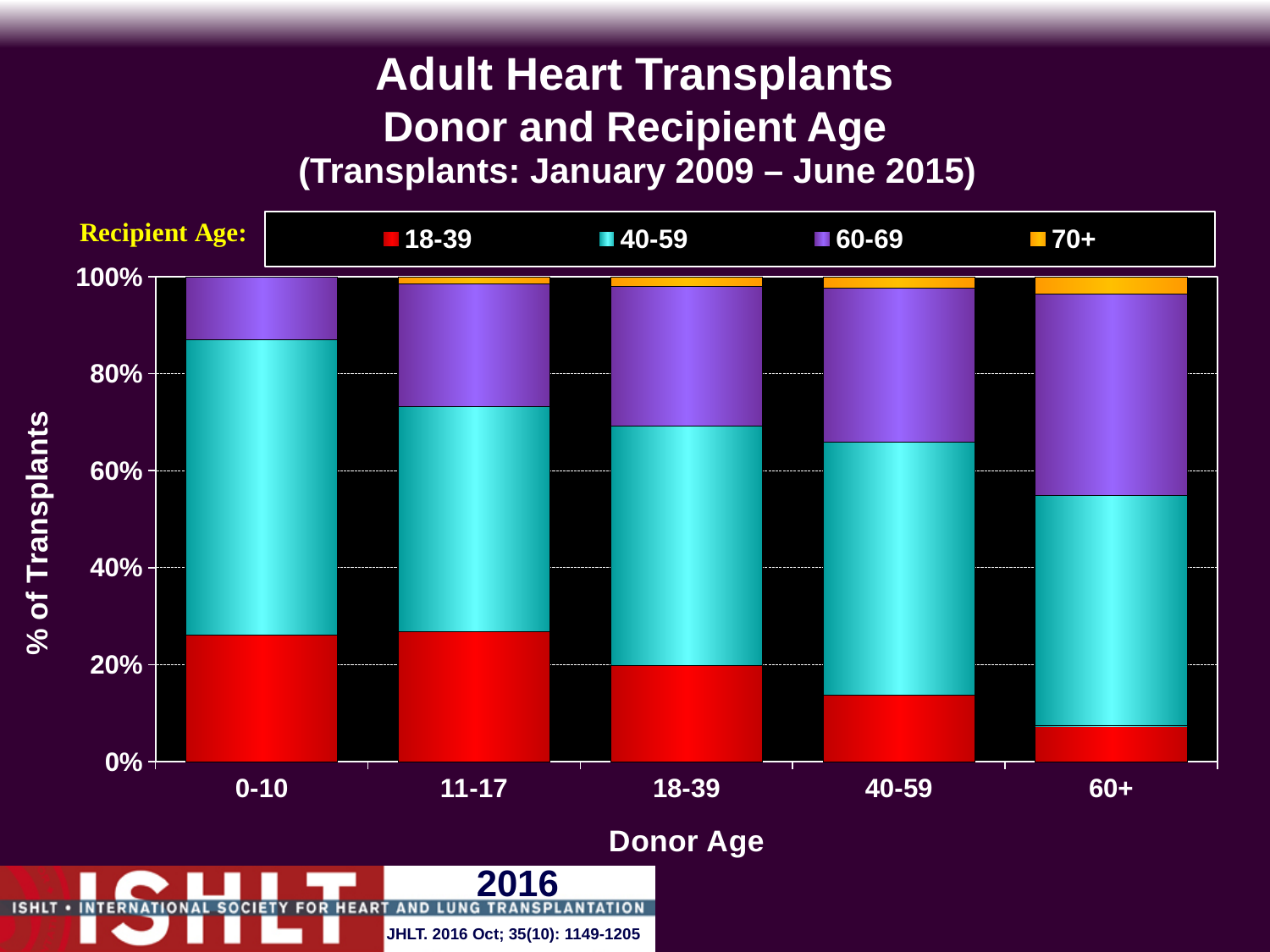
Which donor age group has the largest share of 40-59 recipients? 0-10 Which donor age group has the largest share of 60-69 recipients? 60+ Is the share of 18-39 recipients for donor age 0-10 greater or less than 20%? greater Which donor age group has the smallest share of 18-39 recipients? 60+ How many recipient age series does the legend list? 4 Is the share of 40-59 recipients for donor age 0-10 greater or less than 40%? greater What kind of chart is shown on the slide? Stacked bar chart How many donor age categories are shown on the x axis? 5 What is the label of the y axis? % of Transplants Does the share of 60-69 recipients rise or fall as donor age increases along the x axis? rise Is the share of 18-39 recipients for donor age 60+ greater or less than 20%? less Is the share of 18-39 recipients larger for donor age 0-10 or donor age 60+? 0-10